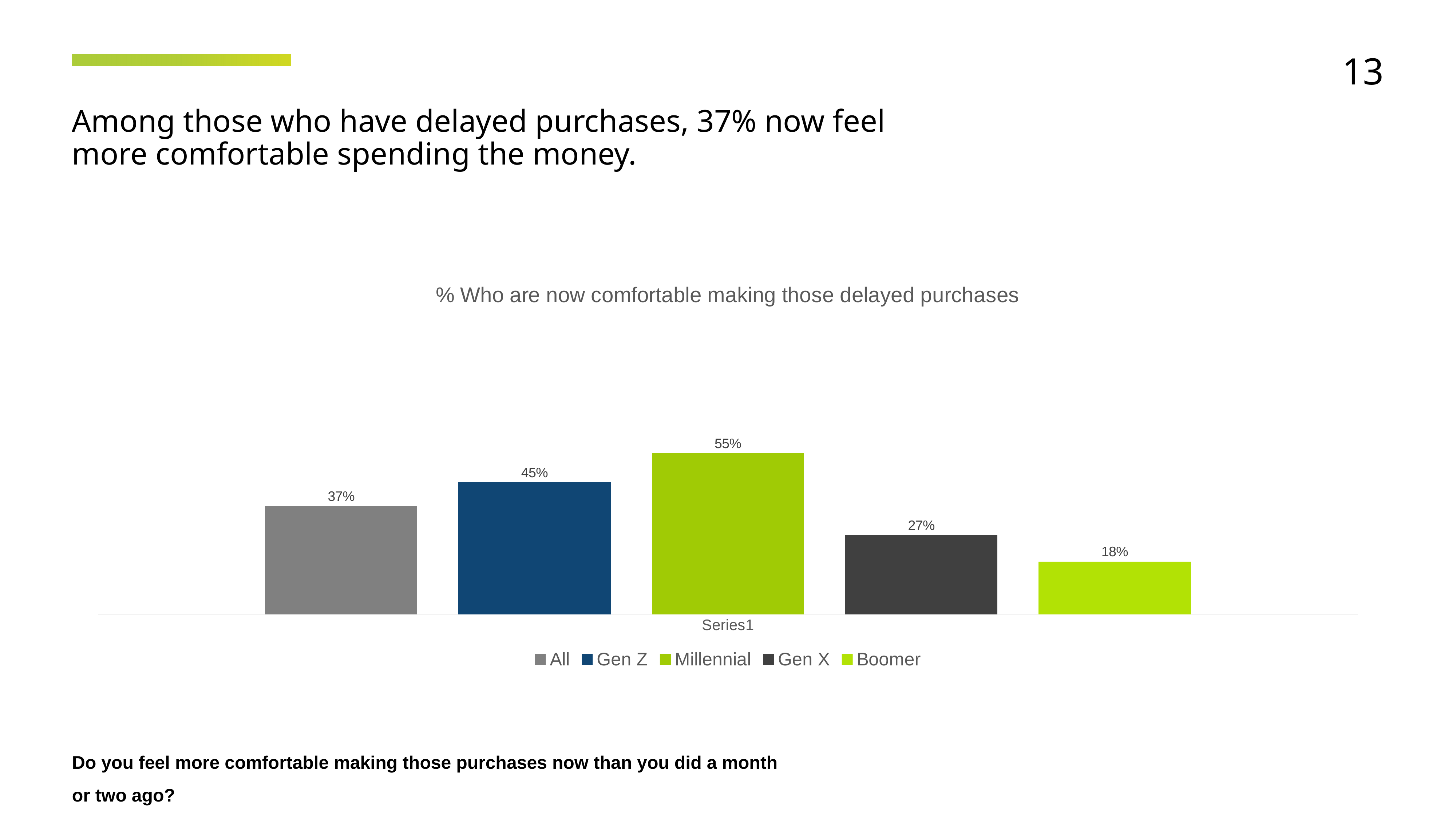
What is the value for All? 37% What kind of chart is shown on the slide? Bar chart What is the difference between the Millennial and Boomer values? 37% What is the value for Boomer? 18% What is the value for Millennial? 55% What is the value for Gen X? 27% How many series does the legend list? 5 Which is larger, the value for Gen Z or the value for All? Gen Z What is the title of the chart? % Who are now comfortable making those delayed purchases Which group has the lowest value? Boomer Which group has the highest value? Millennial What is the difference between the Gen Z and Gen X values? 18%